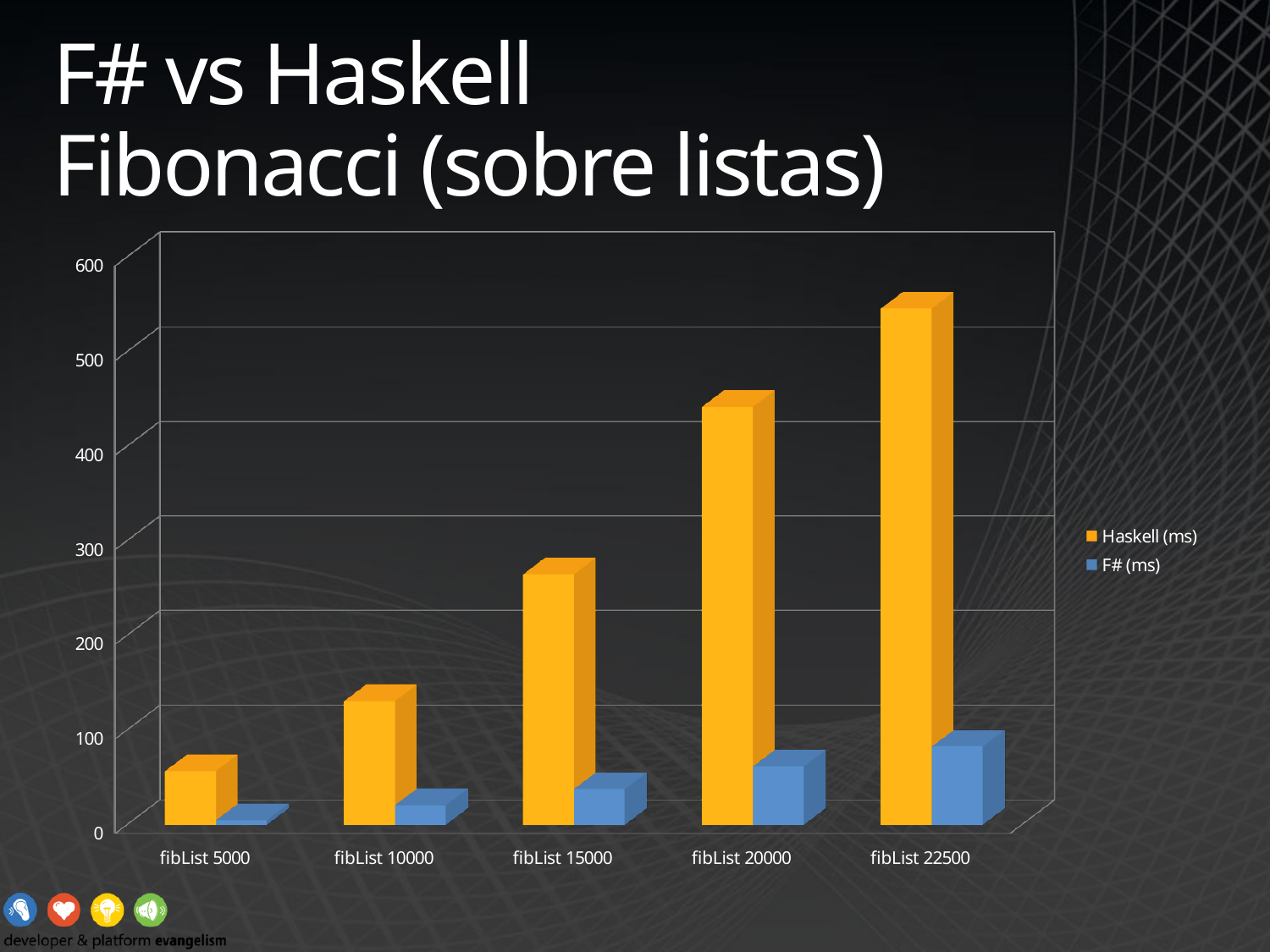
What kind of chart is shown on the slide? bar chart For fibList 22500, which series has the larger value, Haskell (ms) or F# (ms)? Haskell (ms) Which category has the highest Haskell (ms) value? fibList 22500 Do the Haskell (ms) values rise or fall as the list size increases along the x axis? rise What are the two entries listed in the chart's legend? Haskell (ms) and F# (ms) Is the Haskell (ms) value for fibList 5000 greater or less than 100? less How many categories are shown on the x axis of the chart? 5 Is the Haskell (ms) value for fibList 20000 greater or less than 400? greater Which category has the lowest F# (ms) value? fibList 5000 Is the F# (ms) value for fibList 20000 greater or less than 100? less How many series does the chart's legend list? 2